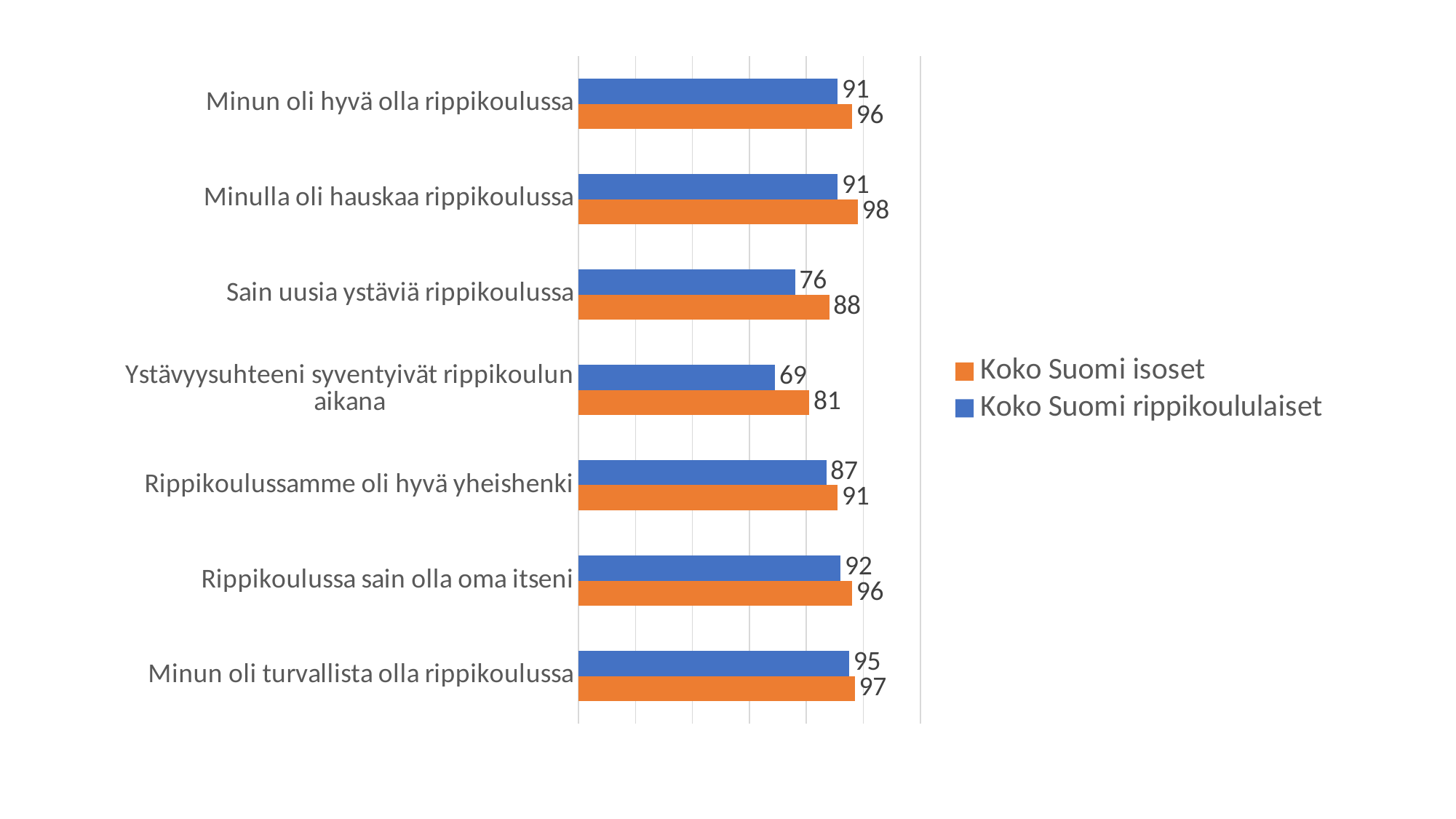
What is the value for 'Koko Suomi rippikoululaiset' for 'Rippikoulussa sain olla oma itseni'? 92 Which category has the highest value for 'Koko Suomi isoset'? Minulla oli hauskaa rippikoulussa Which category has the lowest value for 'Koko Suomi rippikoululaiset'? Ystävyysuhteeni syventyivät rippikoulun aikana What kind of chart is shown on the slide? Bar chart Which is larger for 'Rippikoulussamme oli hyvä yheishenki': 'Koko Suomi isoset' or 'Koko Suomi rippikoululaiset'? Koko Suomi isoset How many categories are shown on the chart? 7 What colour are the bars for 'Koko Suomi isoset'? Orange What is the value for 'Koko Suomi rippikoululaiset' for 'Minun oli turvallista olla rippikoulussa'? 95 How many series does the legend list? 2 What is the difference between 'Koko Suomi isoset' and 'Koko Suomi rippikoululaiset' for 'Sain uusia ystäviä rippikoulussa'? 12 What is the value for 'Koko Suomi rippikoululaiset' for 'Ystävyysuhteeni syventyivät rippikoulun aikana'? 69 What is the value for 'Koko Suomi isoset' for 'Minulla oli hauskaa rippikoulussa'? 98